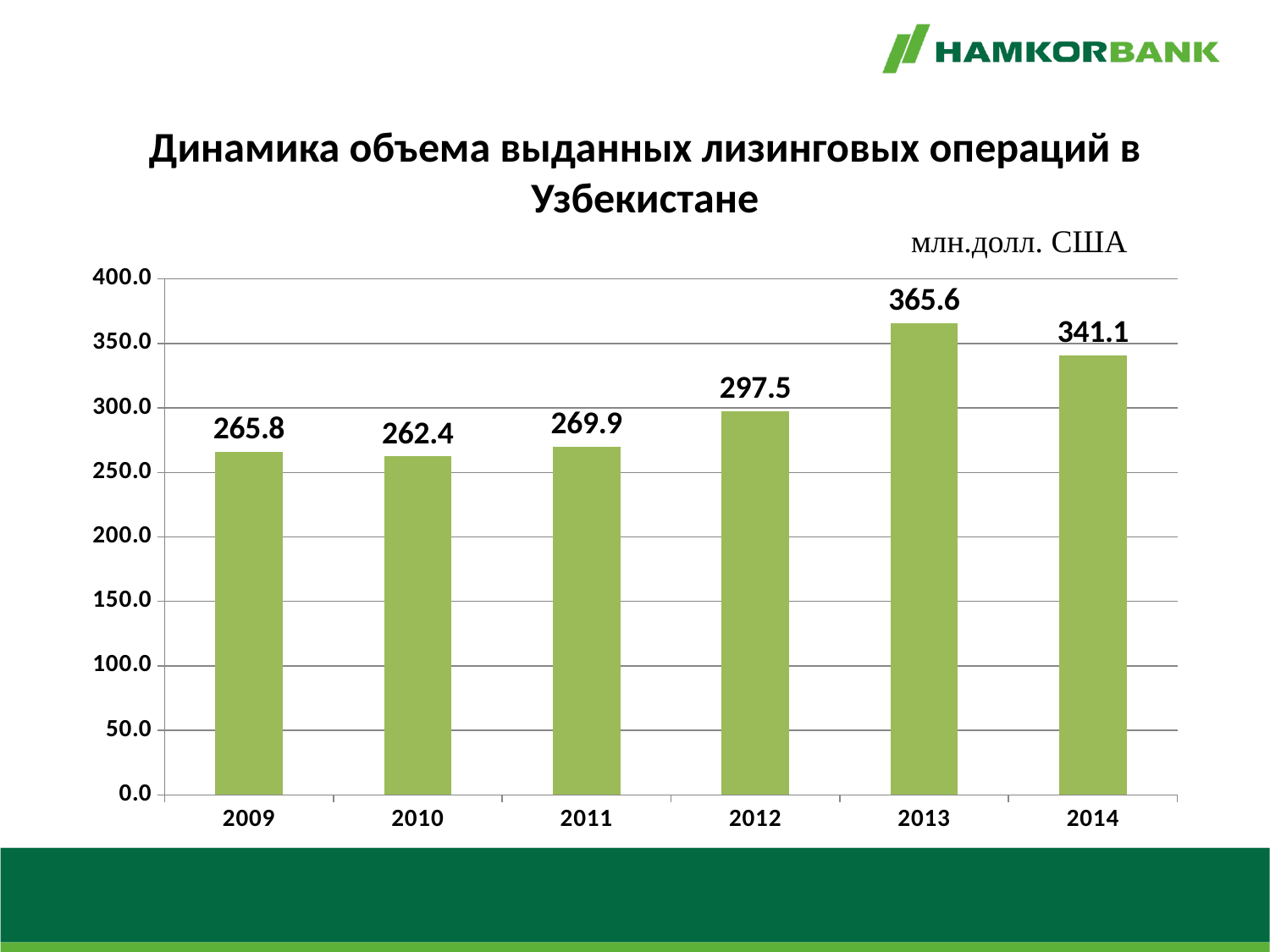
Is the value for 2013 greater or less than 350.0? greater What is the difference between the values for 2012 and 2011? 27.6 Which is larger, the value for 2011 or the value for 2012? 2012 Which year has the lowest value? 2010 What is the value for 2014? 341.1 What is the value for 2012? 297.5 How many years are shown on the x axis? 6 What is the difference between the values for 2013 and 2014? 24.5 What is the value for 2009? 265.8 What kind of chart is shown on the slide? bar chart What unit is indicated above the chart? млн.долл. США Which year has the highest value? 2013